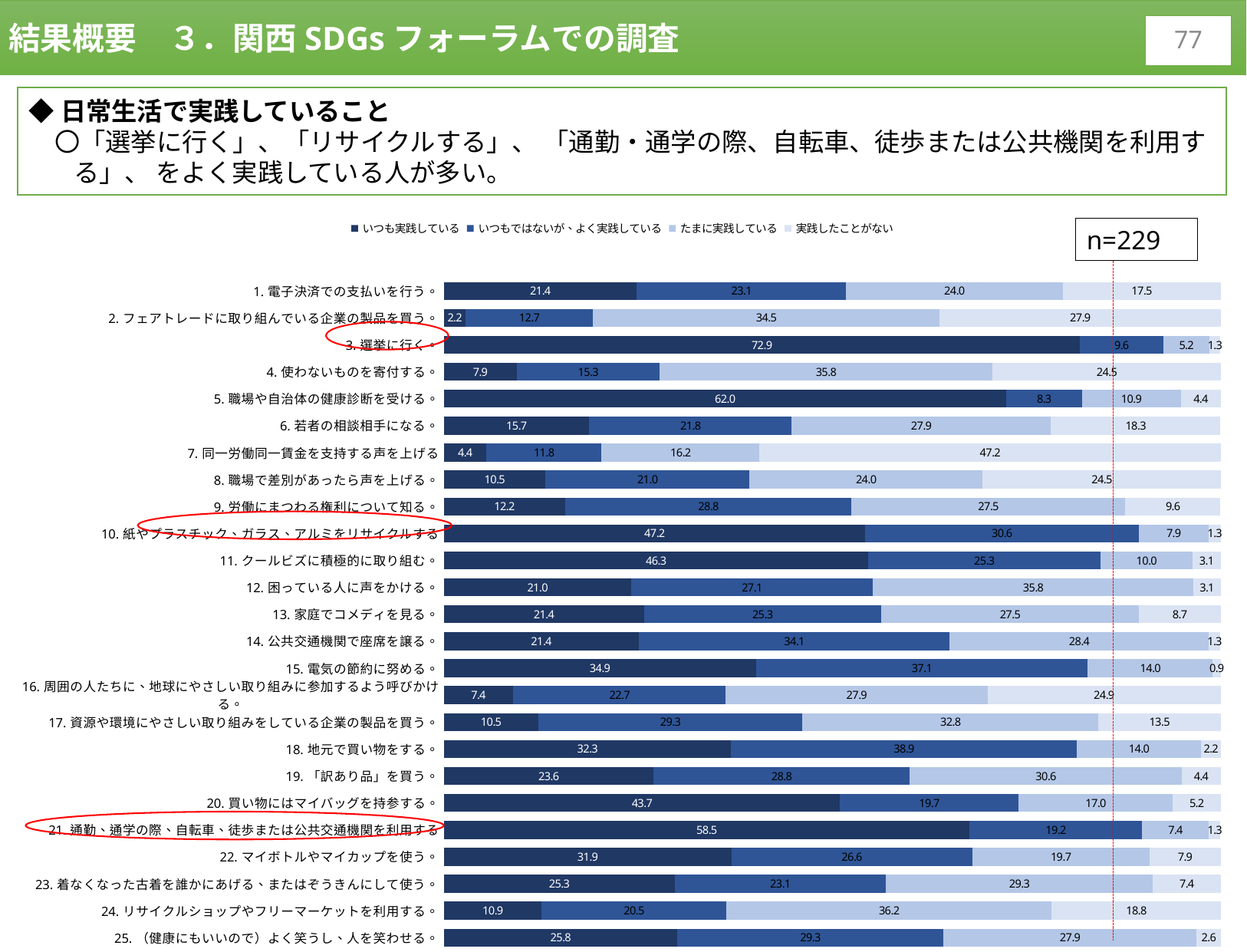
How many series does the legend list? 4 How many categories (items) are plotted in the chart? 25 What is the difference between the 「いつも実践している」 values for 「3. 選挙に行く」 and 「21. 通勤、通学の際、自転車、徒歩または公共交通機関を利用する」? 14.4 Which item has the highest value for 「いつも実践している」? 3. 選挙に行く What kind of chart is shown on the slide? Stacked bar chart What is the value of 「いつも実践している」 for 「3. 選挙に行く」? 72.9 What is the value of 「いつもではないが、よく実践している」 for 「10. 紙やプラスチック、ガラス、アルミをリサイクルする」? 30.6 Which item has the lowest value for 「いつも実践している」? 2. フェアトレードに取り組んでいる企業の製品を買う What sample size (n) is shown on the chart? n=229 What is the value of 「たまに実践している」 for 「1. 電子決済での支払いを行う」? 24.0 What is the value of 「実践したことがない」 for 「7. 同一労働同一賃金を支持する声を上げる」? 47.2 Which has a larger 「いつも実践している」 value: 「5. 職場や自治体の健康診断を受ける」 or 「20. 買い物にはマイバッグを持参する」? 5. 職場や自治体の健康診断を受ける